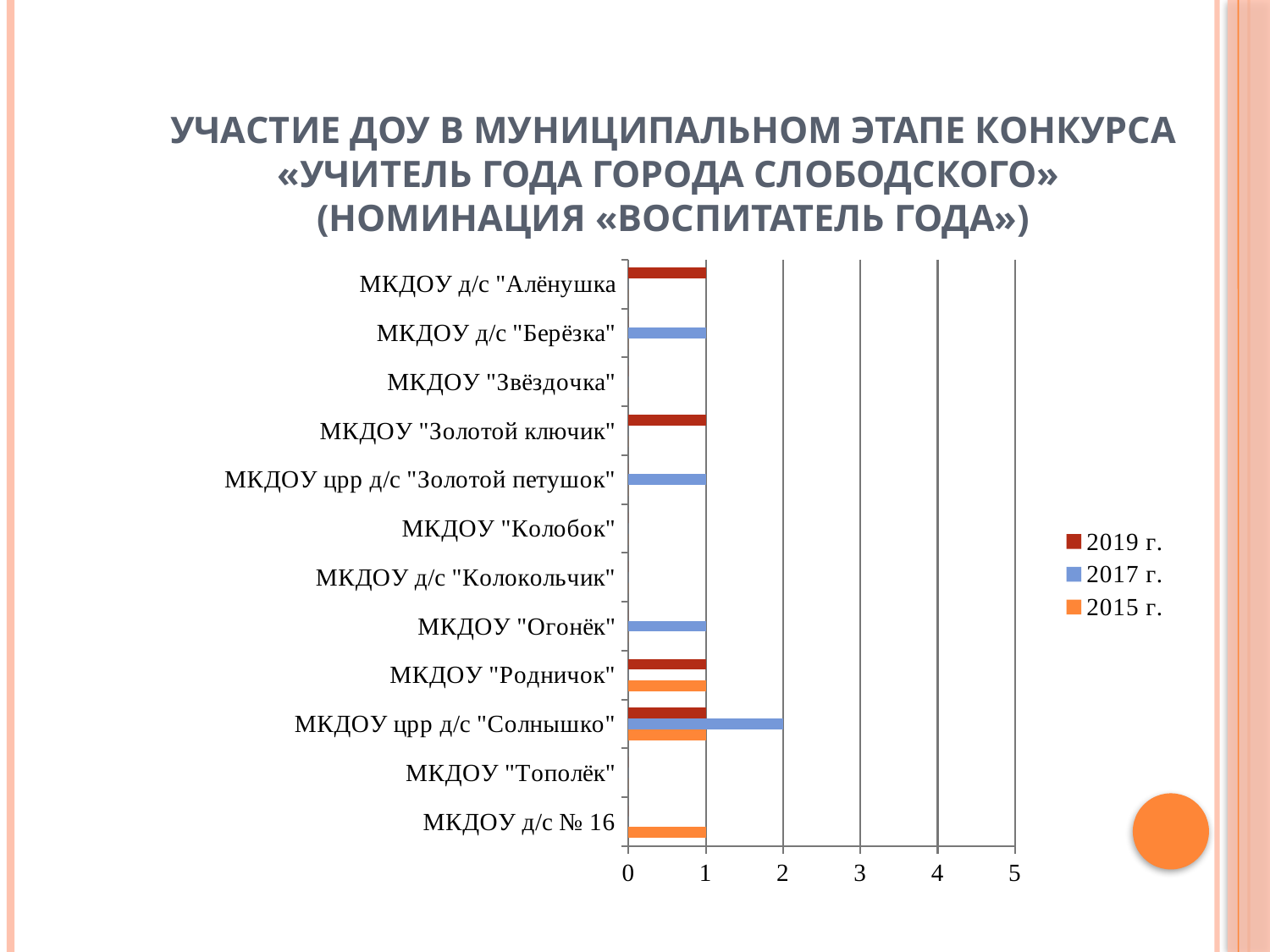
How many categories (institutions) are listed on the vertical axis? 12 Is the 2017 г. value for МКДОУ црр д/с "Солнышко" greater or less than 3? less What is the value for МКДОУ д/с № 16 in the 2015 г. series? 1 What is the value for МКДОУ црр д/с "Солнышко" in the 2017 г. series? 2 How many series does the legend list? 3 What kind of chart is shown on the slide? bar chart Which series is shown in orange in the legend? 2015 г. What is the difference between the 2017 г. value for МКДОУ црр д/с "Солнышко" and the 2017 г. value for МКДОУ д/с "Берёзка"? 1 Which is larger: the 2017 г. value for МКДОУ црр д/с "Солнышко" or the 2017 г. value for МКДОУ "Огонёк"? МКДОУ црр д/с "Солнышко" What is the value for МКДОУ д/с "Алёнушка" in the 2019 г. series? 1 Which institution has the highest value in the 2017 г. series? МКДОУ црр д/с "Солнышко" What is the highest value shown on the horizontal axis? 5